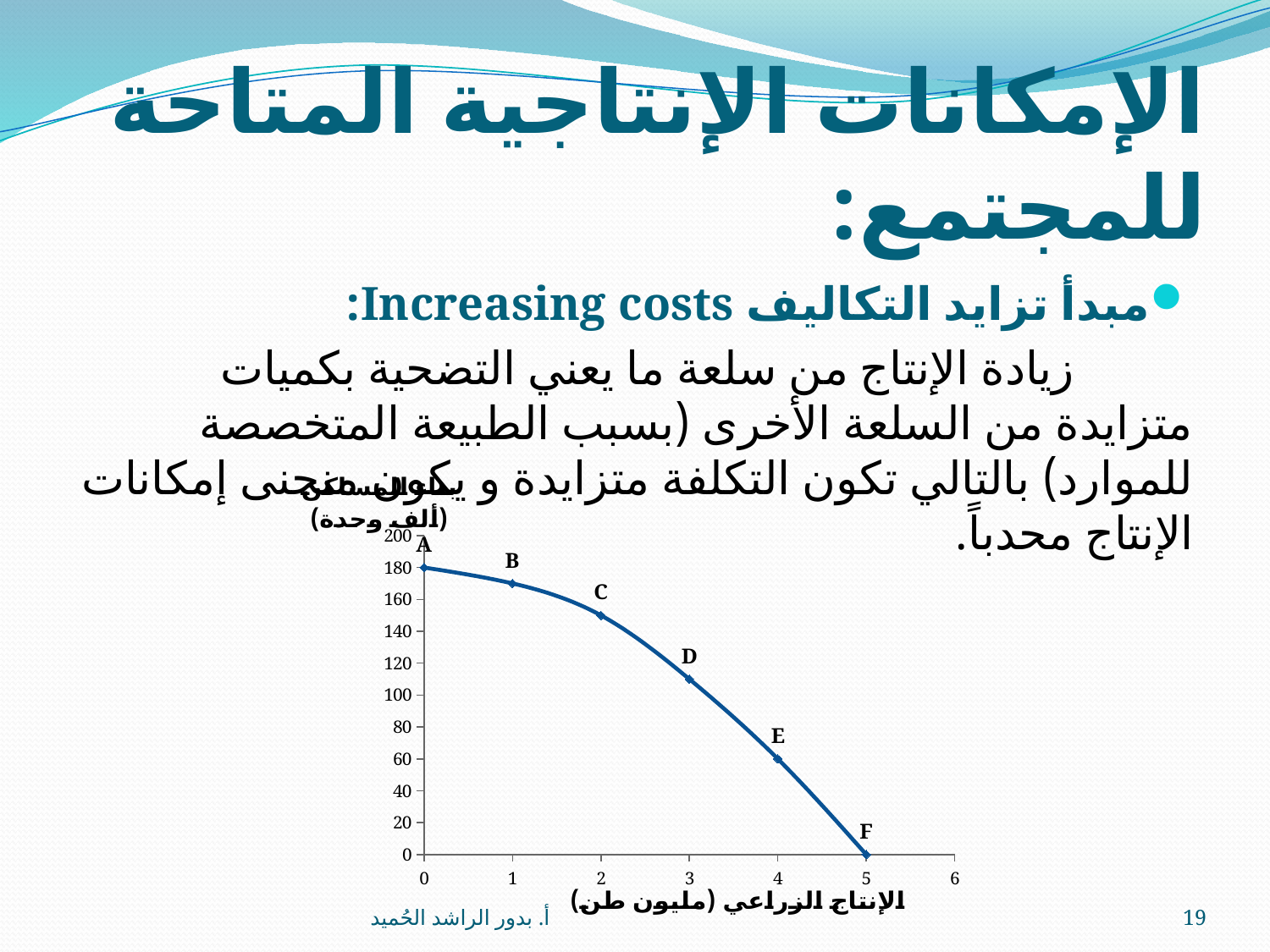
What type of chart is shown on the slide? line chart What is the y-axis value of point F? 0 What is the y-axis value of point E? 60 Which labelled point has the lowest y-axis value? F Is the y-axis value of point D greater or less than 120? less Which labelled point has the highest y-axis value? A What is the y-axis value of point A? 180 Do the values rise or fall as the x-axis value increases? fall Which point has a larger y-axis value, C or D? C What is the x-axis value of point D? 3 How many labelled points are plotted on the curve? 6 Is the y-axis value of point B greater or less than 160? greater